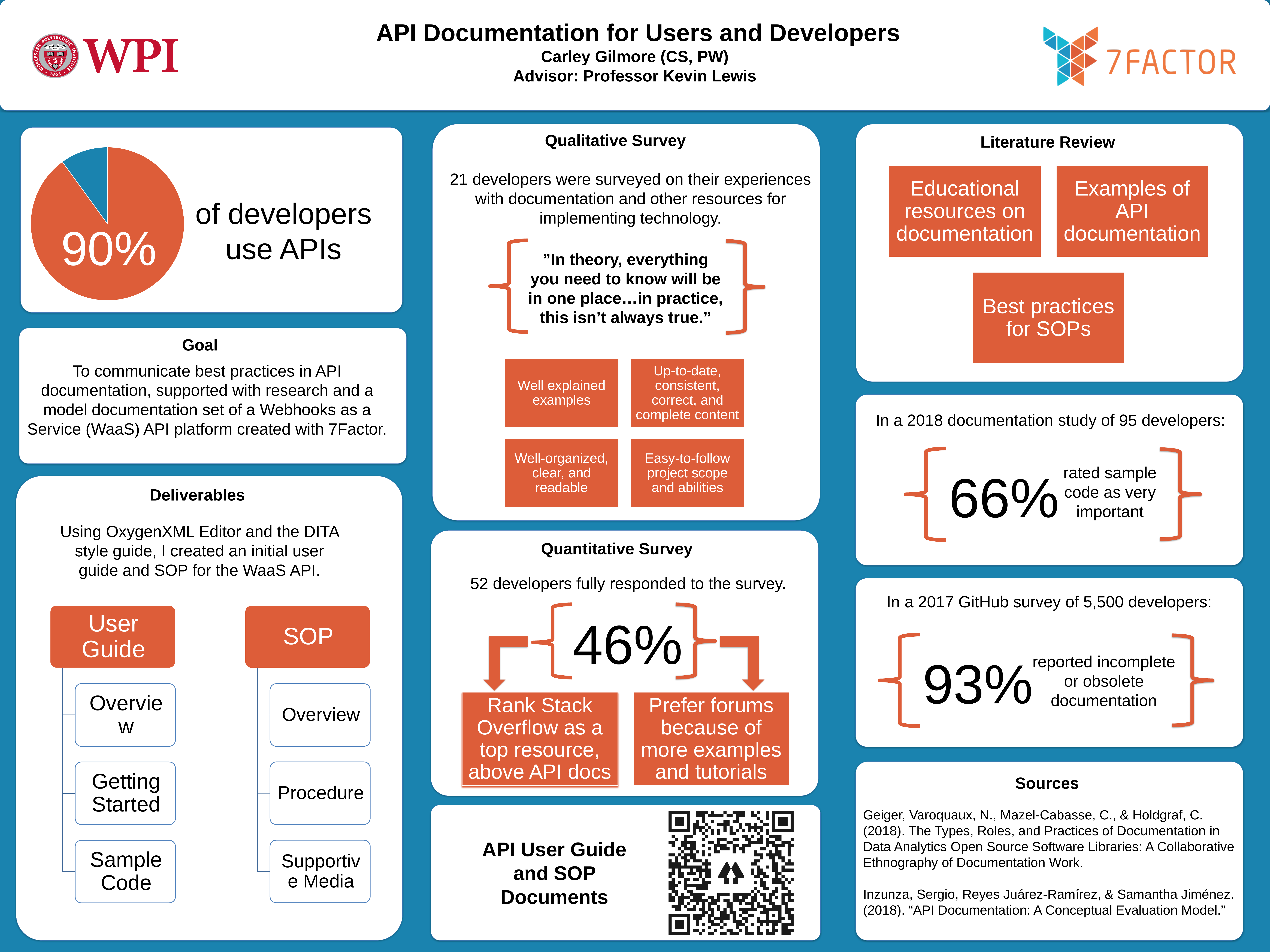
In the pie chart in the top-left panel, which slice is larger, the orange one or the blue one? the orange one What share of the pie chart in the top-left panel does the orange slice represent? 90% What colour is the slice labelled 90% in the pie chart in the top-left panel? orange In the pie chart in the top-left panel, which slice is the smallest? the blue slice What text accompanies the pie chart in the top-left panel to describe what the 90% represents? of developers use APIs What kind of chart is shown in the top-left panel of the slide? pie chart In the pie chart in the top-left panel, what percentage of developers use APIs? 90% How many slices does the pie chart in the top-left panel have? 2